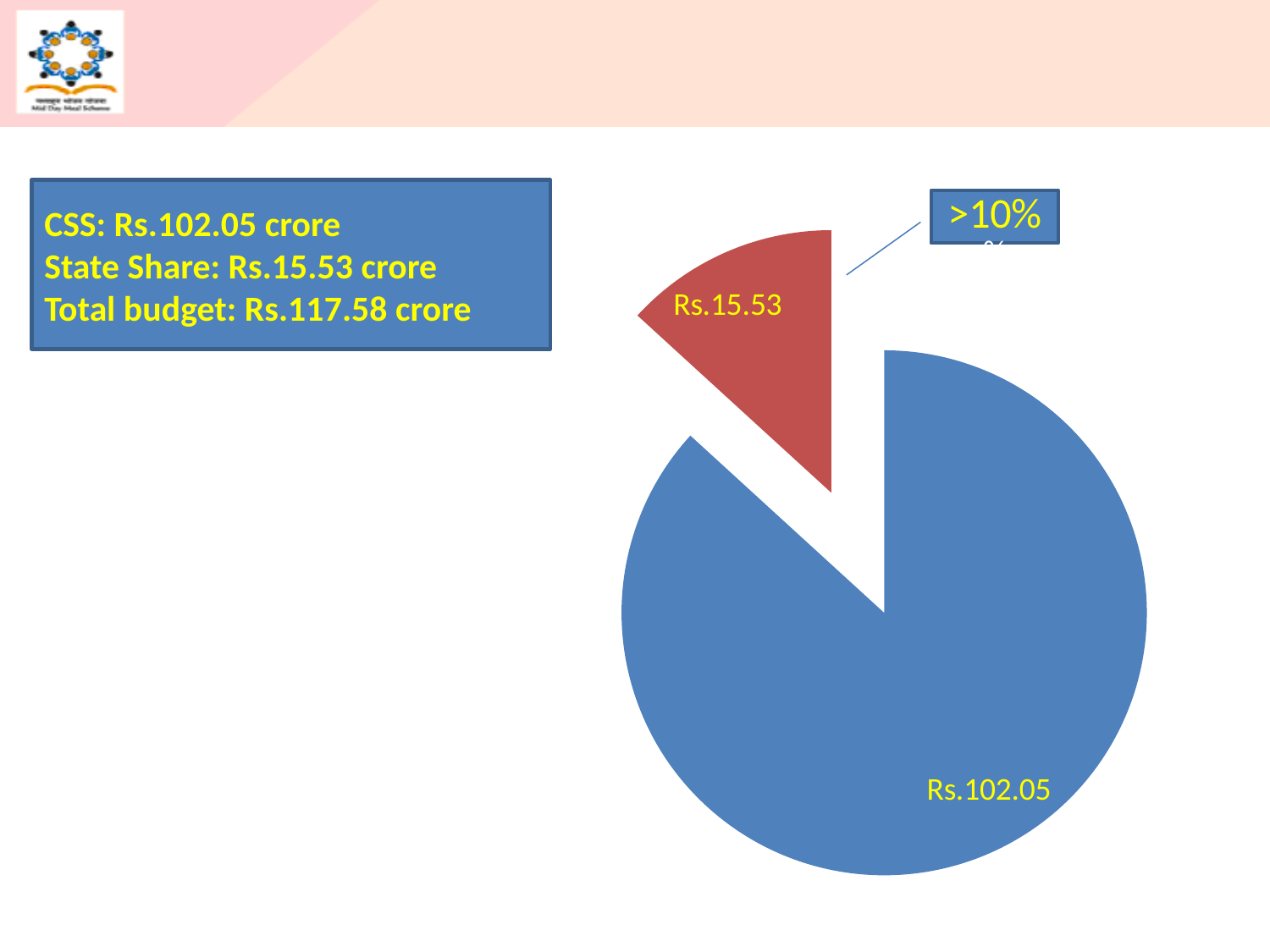
How many slices does the pie chart have? 2 What does the callout box next to the red slice of the pie chart say? >10% What is the total of the two slice values shown in the pie chart? Rs.117.58 What value is labelled on the red slice of the pie chart? Rs.15.53 Which slice of the pie chart is the smallest? Rs.15.53 (State Share) What colour is the slice representing the State Share (Rs.15.53) in the pie chart? red Which slice of the pie chart is the largest? Rs.102.05 (CSS) Is the blue slice (Rs.102.05) or the red slice (Rs.15.53) larger in the pie chart? the blue slice (Rs.102.05) What is the difference between the two slice values in the pie chart, Rs.102.05 and Rs.15.53? Rs.86.52 What kind of chart is shown on the slide? pie chart According to the text box, what is the total budget? Rs.117.58 crore What value is labelled on the blue slice of the pie chart? Rs.102.05